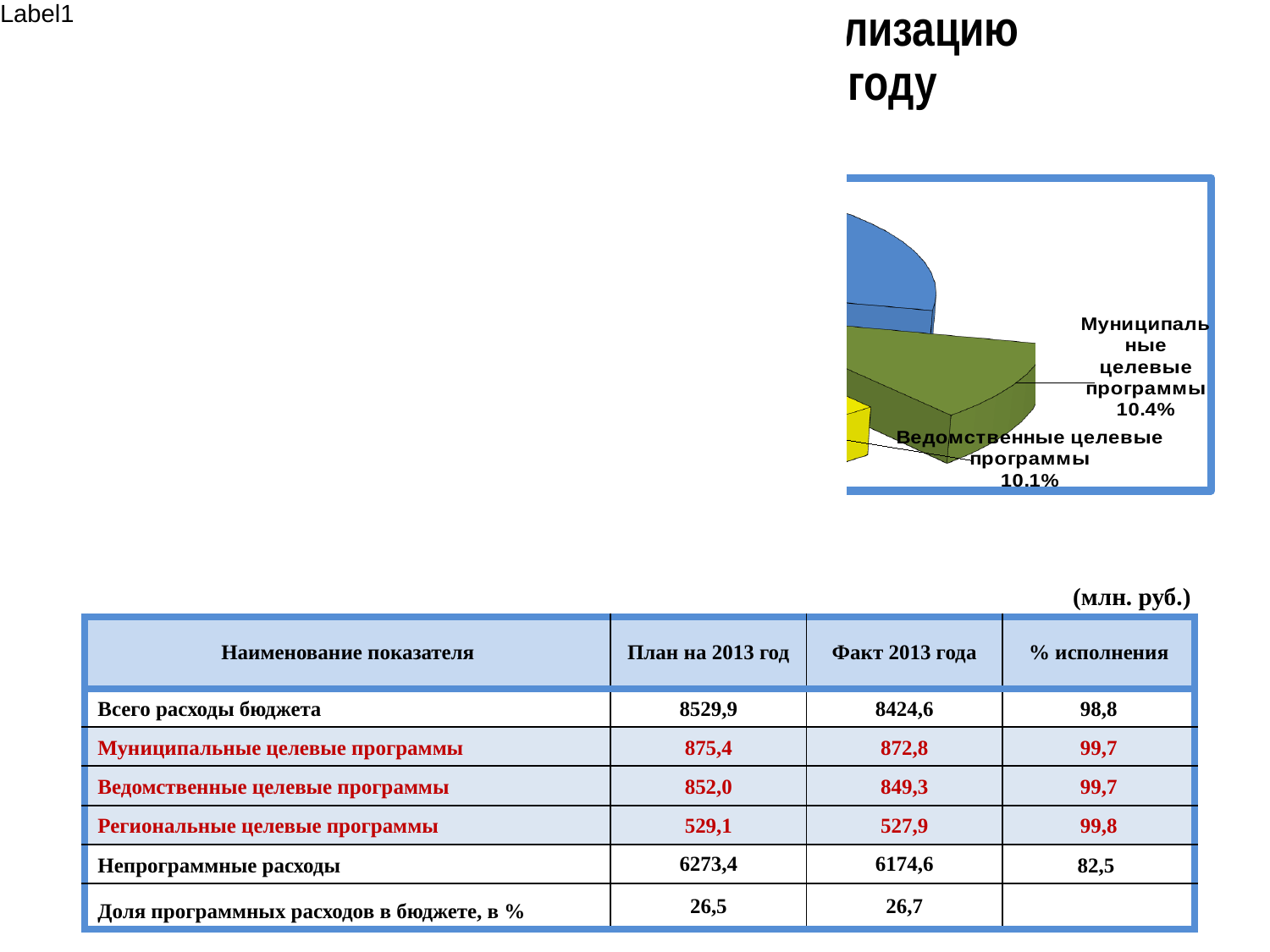
Which slice is larger: Муниципальные целевые программы or Ведомственные целевые программы? Муниципальные целевые программы What kind of chart is shown on the slide? pie chart What colour is the slice labelled Муниципальные целевые программы? green What share of the pie is labelled for Муниципальные целевые программы? 10.4% What colour is the slice labelled Ведомственные целевые программы? yellow By how many percentage points does the Муниципальные целевые программы slice exceed the Ведомственные целевые программы slice? 0.3% What share of the pie is labelled for Ведомственные целевые программы? 10.1%